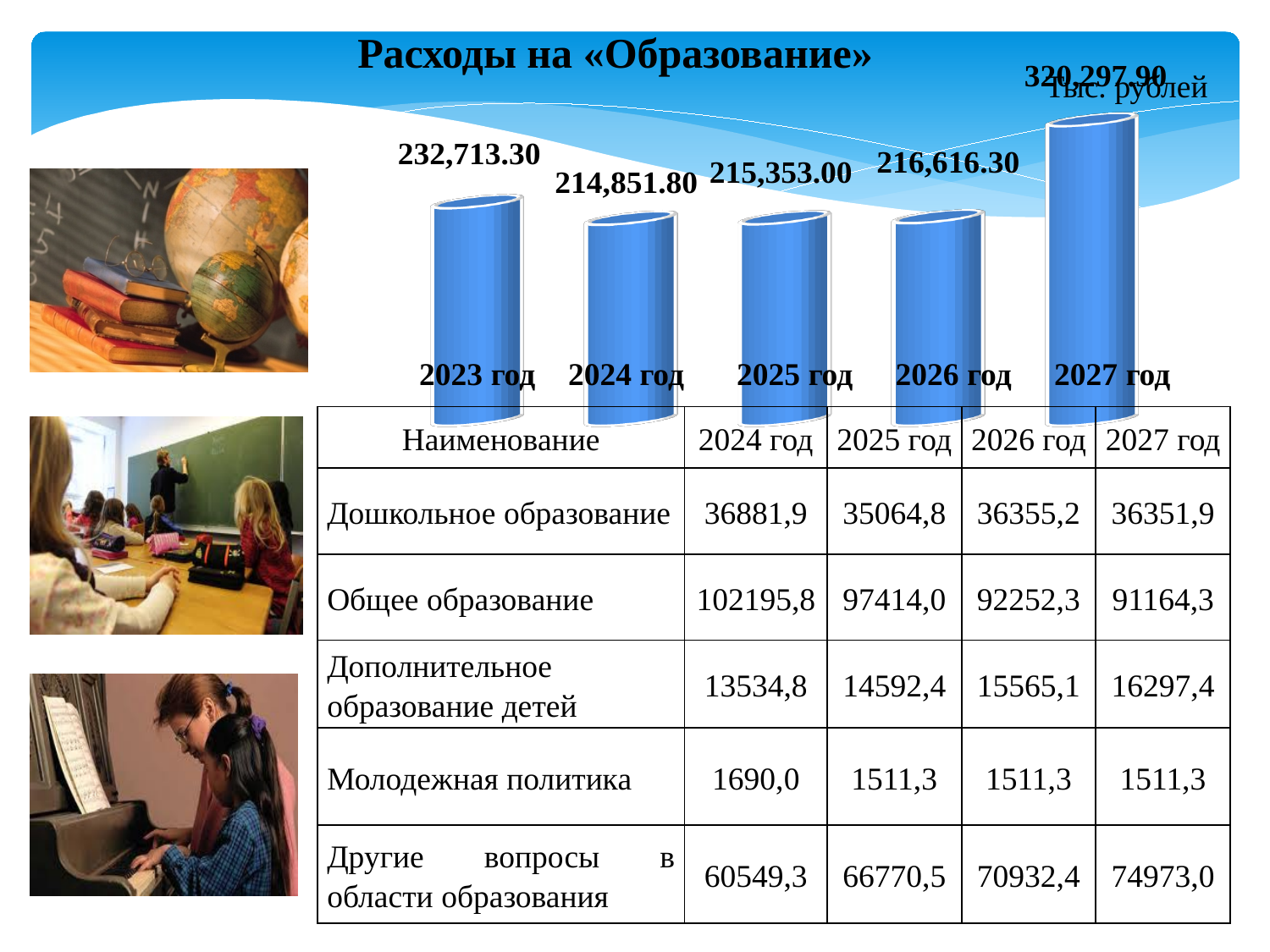
From 2024 год to 2027 год, do the values rise or fall? rise Which year has the highest value in the chart? 2027 год What is the value for 2023 год in the chart «Расходы на «Образование»»? 232,713.30 What is the difference between the values for 2027 год and 2023 год? 87,584.60 How many years are shown in the chart? 5 What is the title of the chart? Расходы на «Образование» What is the value for 2025 год in the chart? 215,353.00 Which is larger, the value for 2026 год or the value for 2025 год? 2026 год Which year has the lowest value in the chart? 2024 год What kind of chart is shown on the slide? bar chart What is the value for 2027 год in the chart? 320,297.90 What is the difference between the values for 2023 год and 2024 год? 17,861.50